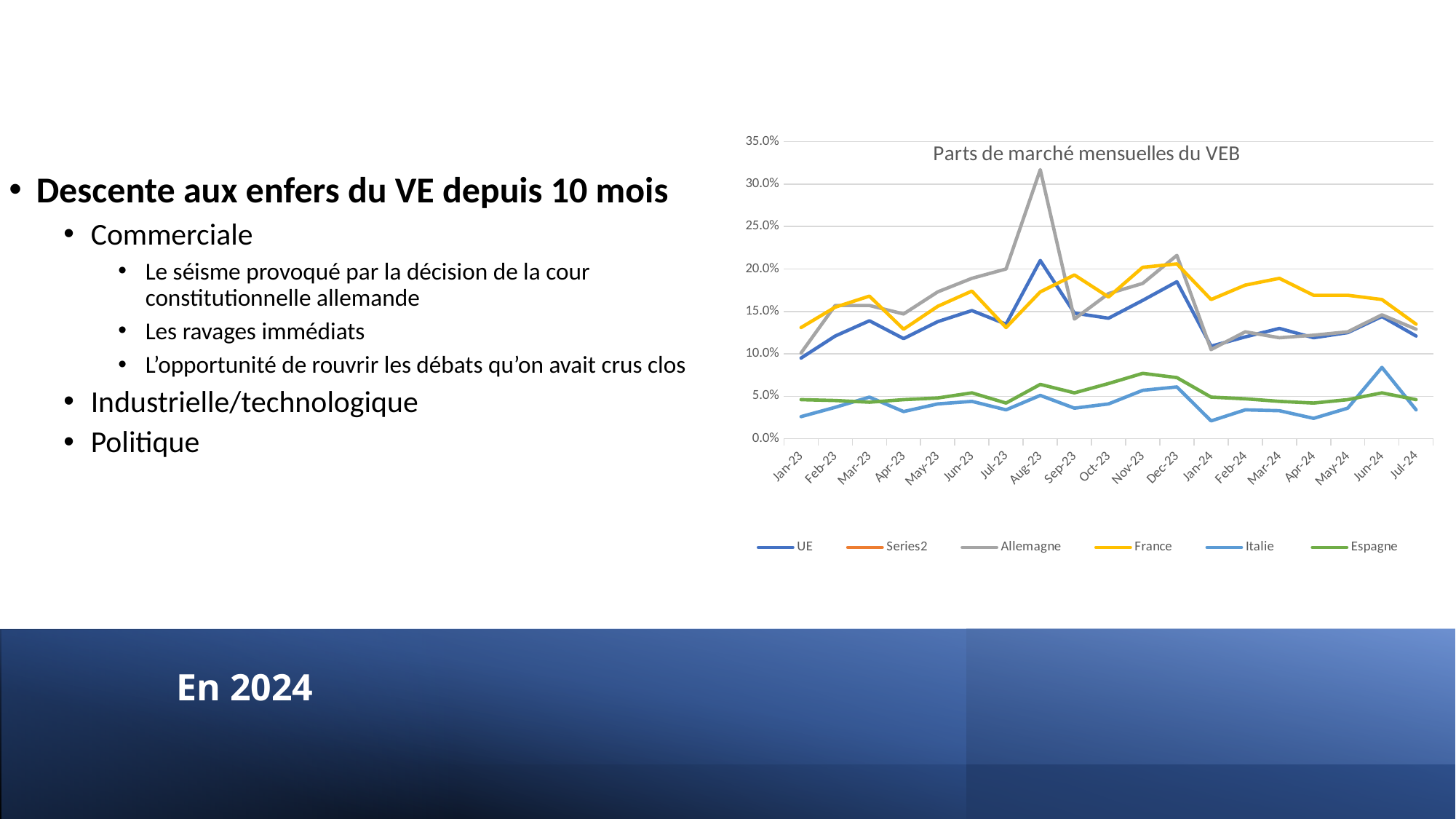
How many months are shown along the x axis of the chart? 19 Is the value for Italie in Jan-24 greater or less than 5%? less In Jun-24, which is higher: Italie or Espagne? Italie Is the value for France in Nov-23 greater or less than 15%? greater What is the title of the chart? Parts de marché mensuelles du VEB What kind of chart is shown on the slide? line chart Is the value for Allemagne in Aug-23 greater or less than 25%? greater How many series does the chart legend list? 6 In which month does the Allemagne series reach its peak? Aug-23 Does the UE series rise or fall between Dec-23 and Jan-24? fall Which series reaches the highest value anywhere on the chart? Allemagne